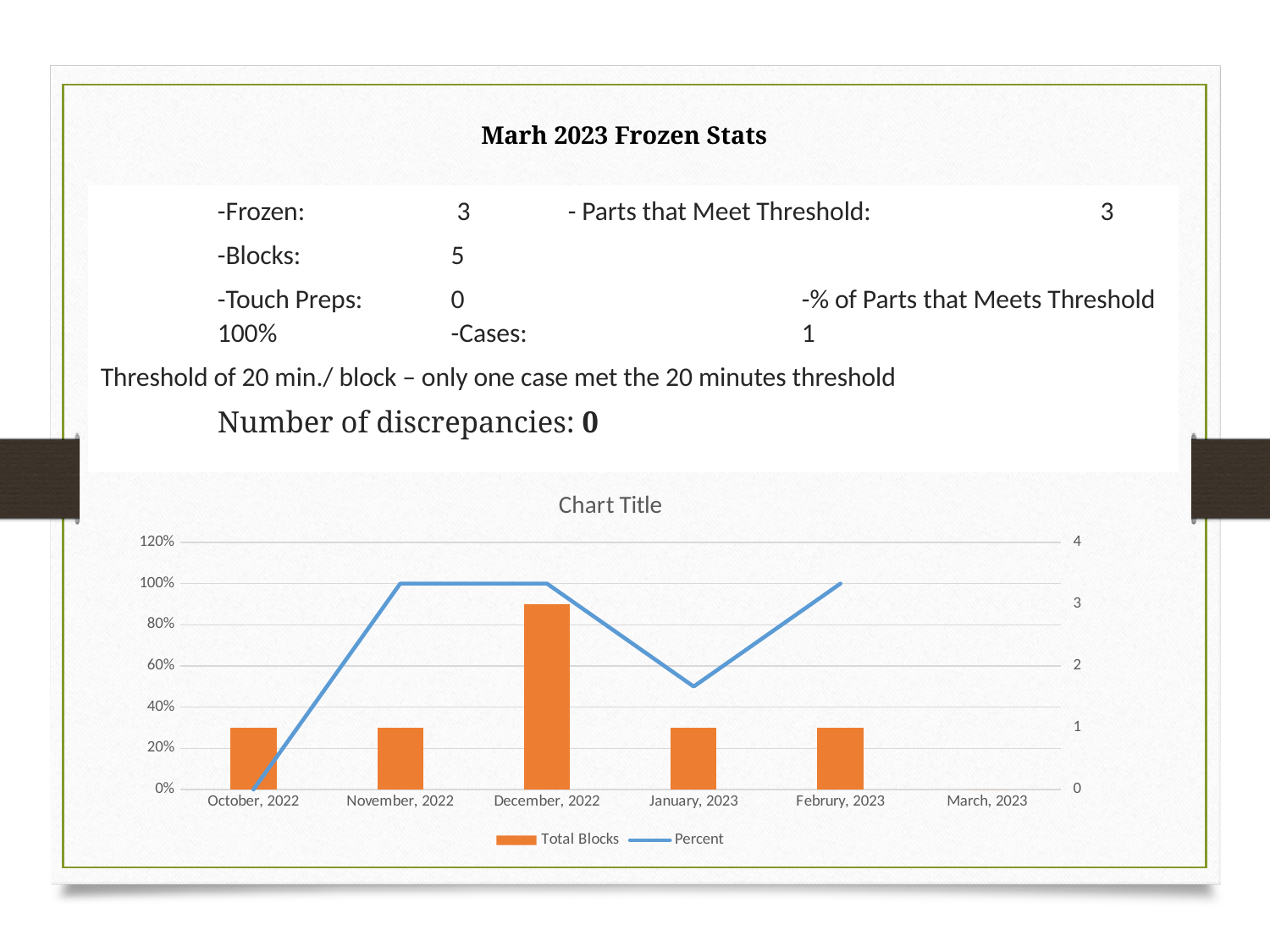
Which month has the lowest Percent value? October, 2022 How many series does the chart legend list? 2 What is the Percent value for November, 2022? 100% What are the two series named in the chart legend? Total Blocks and Percent How many month categories are shown on the x axis of the chart? 6 Does the Percent line rise or fall from December, 2022 to January, 2023? Fall What is the Total Blocks value for December, 2022 on the right-hand axis? 3 Which month has the highest Total Blocks bar? December, 2022 Is the Percent value for January, 2023 greater or less than 60%? less What is the Percent value for October, 2022? 0% Which has the larger Total Blocks bar, December, 2022 or January, 2023? December, 2022 What type of chart is shown on the slide? A combination bar and line chart